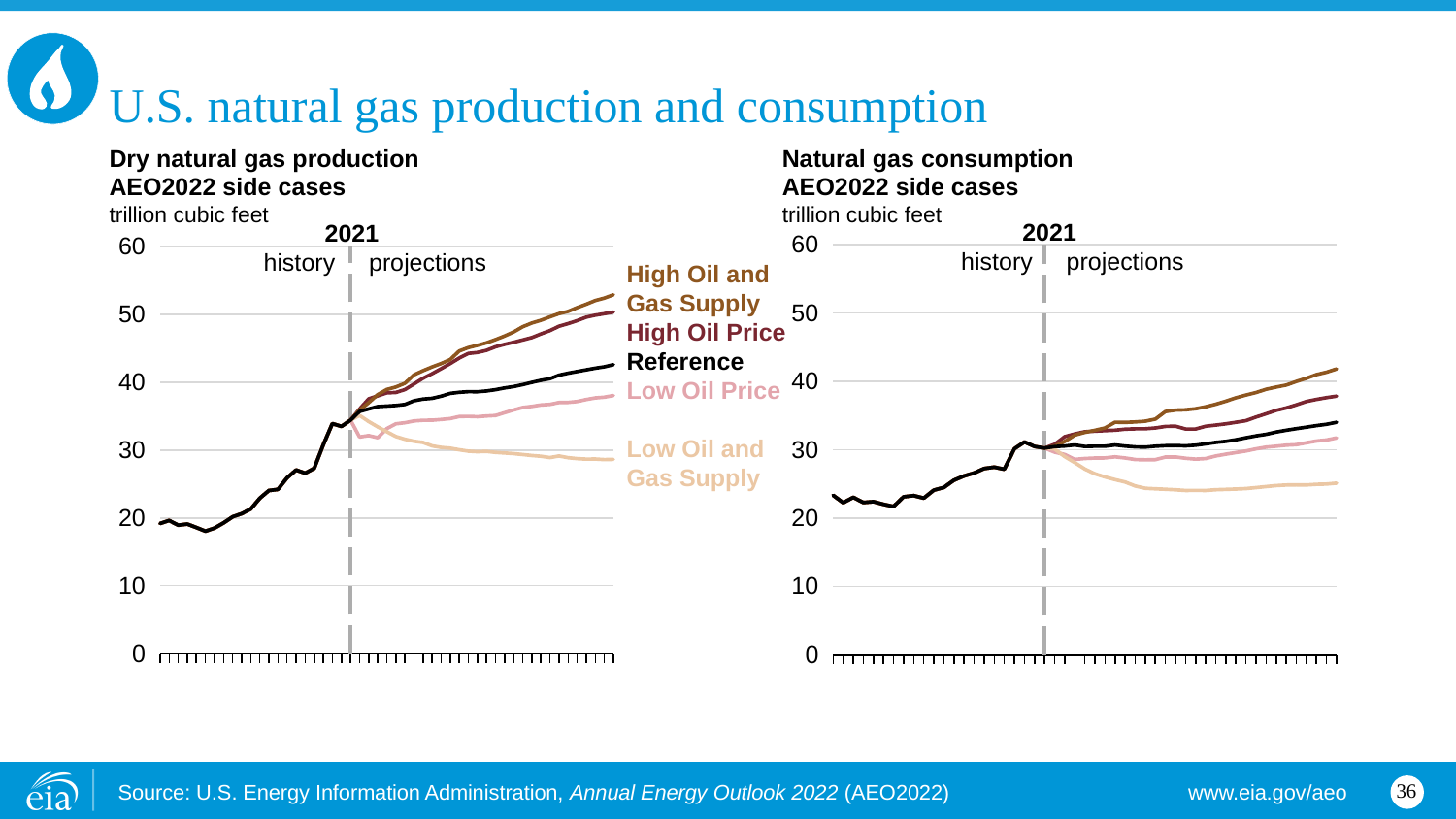
In the 'Natural gas consumption' chart, is the value for the Reference case at the end of the projections greater or less than 30? greater In the 'Natural gas consumption' chart, is the value for Low Oil and Gas Supply at the end of the projections greater or less than 30? less In the 'Dry natural gas production' chart, which series is lowest at the end of the projection period? Low Oil and Gas Supply How many side-case series are labelled on the 'Dry natural gas production' chart? 5 In the 'Dry natural gas production' chart, is the value for Low Oil and Gas Supply at the end of the projections greater or less than 30? less What kind of chart is the 'Dry natural gas production' chart on the left? line chart In the 'Dry natural gas production' chart, which series is highest at the end of the projection period? High Oil and Gas Supply In the 'Dry natural gas production' chart, at the end of the projections, which is higher: High Oil Price or Reference? High Oil Price What unit is used on the y axis of both charts? trillion cubic feet In the 'Natural gas consumption' chart, does the Reference series rise or fall over the projection period? rise In the 'Dry natural gas production' chart, does the Low Oil and Gas Supply series rise or fall over the projection period? fall